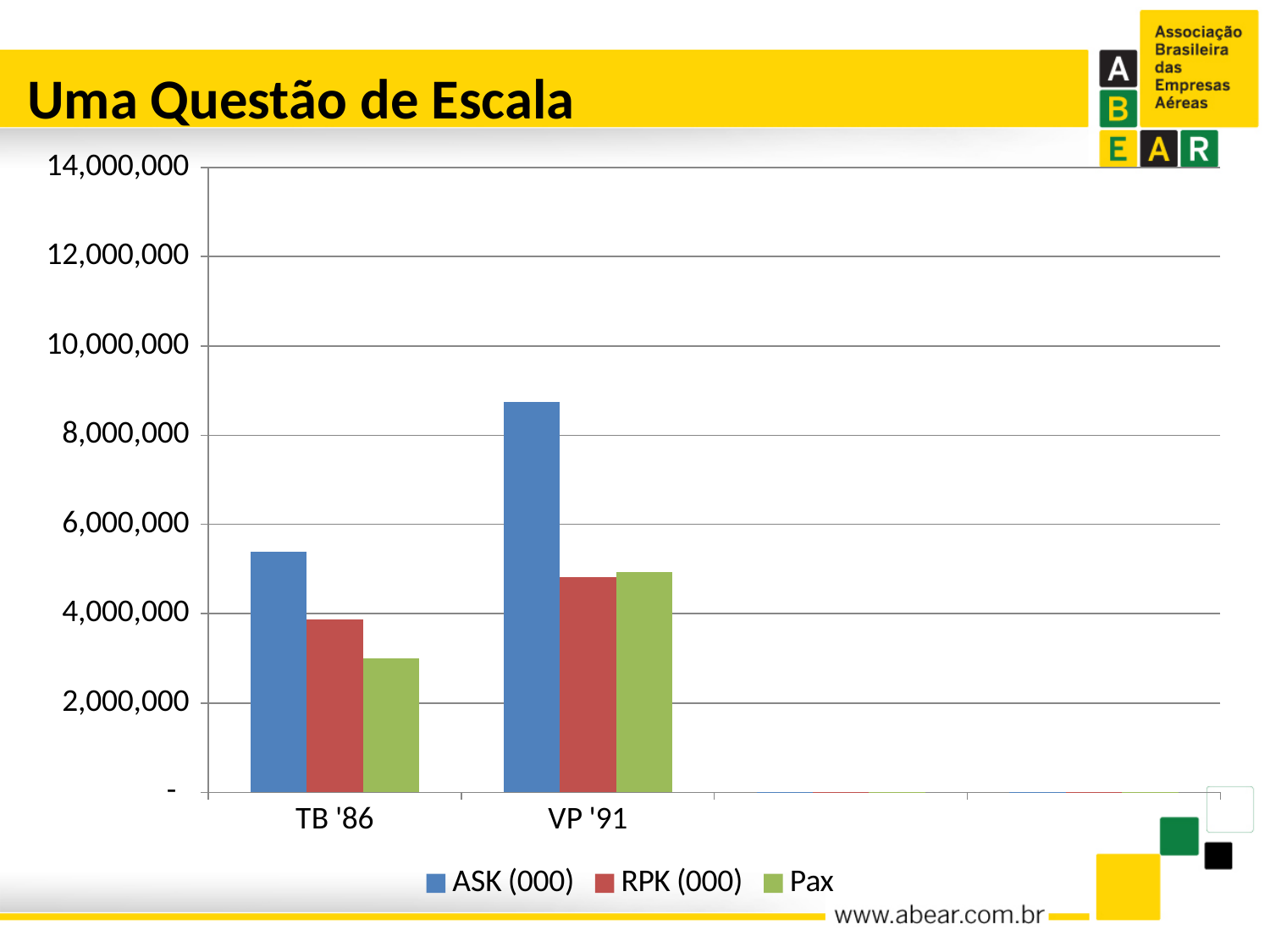
How many series does the chart legend list? 3 Which is larger, the ASK (000) value for TB '86 or the ASK (000) value for VP '91? VP '91 What is the title of the slide containing the chart? Uma Questão de Escala Is the Pax value for TB '86 greater or less than 4,000,000? less Which series is shown in blue in the chart legend? ASK (000) Which series has the lowest value for TB '86? Pax Is the ASK (000) value for TB '86 greater or less than 4,000,000? greater Is the RPK (000) value for VP '91 greater or less than 6,000,000? less What kind of chart is shown on the slide? bar chart Which series has the highest value for VP '91? ASK (000)